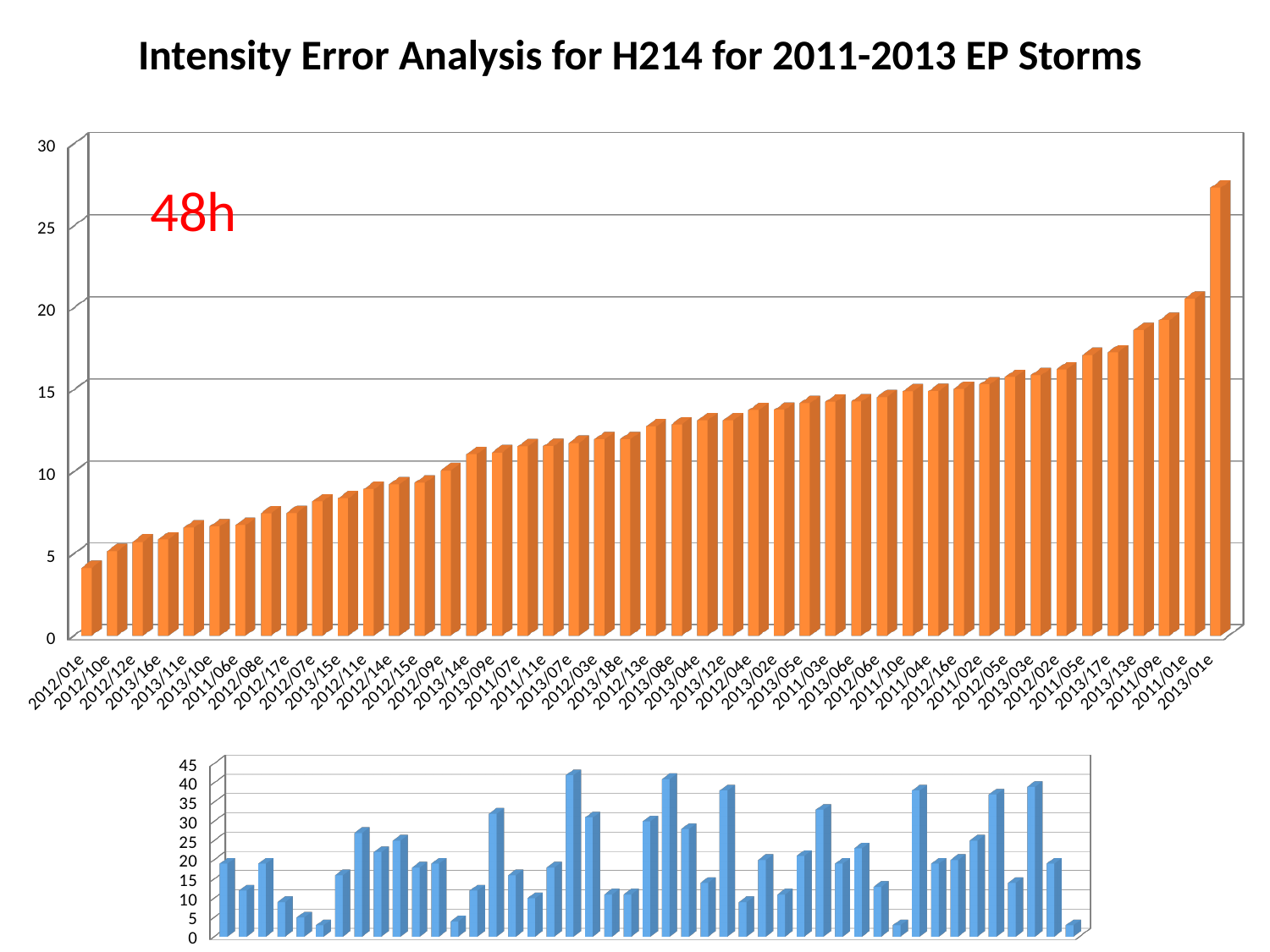
In the top chart, is the value for 2012/01e greater or less than 5? less In the top chart, is the value for 2012/17e greater or less than 10? less In the top chart, is the value for 2013/13e greater or less than 15? greater What forecast lead time is labelled in red on the top chart? 48h What kind of chart is the top chart on the slide? bar chart In the top chart, which storm has the lowest intensity error? 2012/01e What colour are the bars in the bottom chart? blue In the top chart, which is larger, the value for 2011/09e or the value for 2012/10e? 2011/09e In the top chart, do the values rise or fall from left to right along the x axis? rise How many storms (bars) are shown in the top chart? 45 In the top chart, which storm has the highest intensity error? 2013/01e